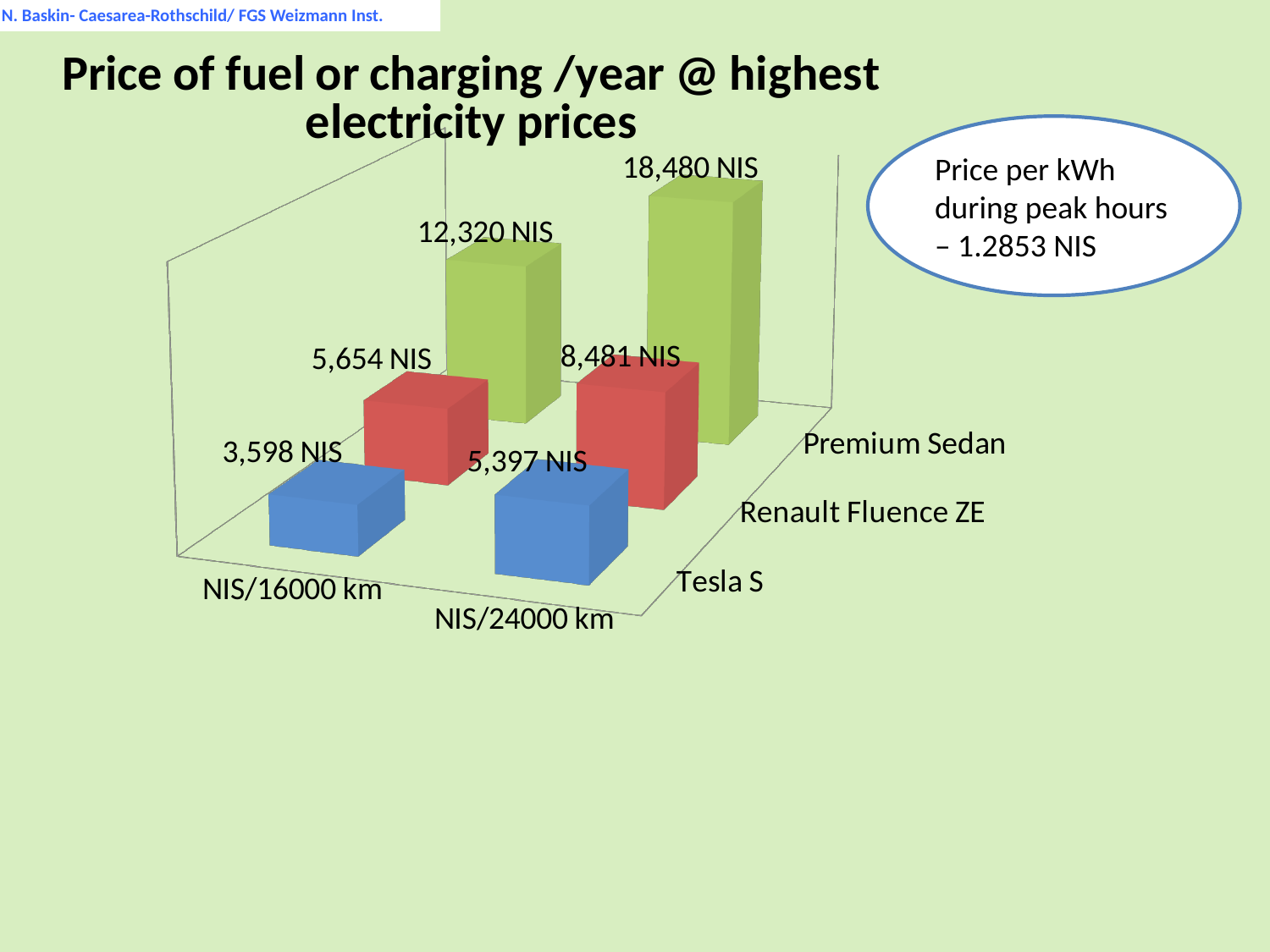
Which vehicle has the highest value at NIS/24000 km? Premium Sedan What is the difference between the Renault Fluence ZE and Tesla S values at NIS/24000 km? 3,084 NIS What is the value for Premium Sedan at NIS/24000 km? 18,480 NIS What is the difference between the Premium Sedan values at NIS/24000 km and NIS/16000 km? 6,160 NIS What is the value for Tesla S at NIS/16000 km? 3,598 NIS What is the value for Renault Fluence ZE at NIS/24000 km? 8,481 NIS Which is larger: the Renault Fluence ZE value at NIS/16000 km or the Tesla S value at NIS/24000 km? Renault Fluence ZE at NIS/16000 km How many vehicle types are plotted in the chart? 3 What is the value for Premium Sedan at NIS/16000 km? 12,320 NIS Which vehicle has the lowest value at NIS/16000 km? Tesla S What is the title of the chart? Price of fuel or charging /year @ highest electricity prices What kind of chart is shown on the slide? Bar chart